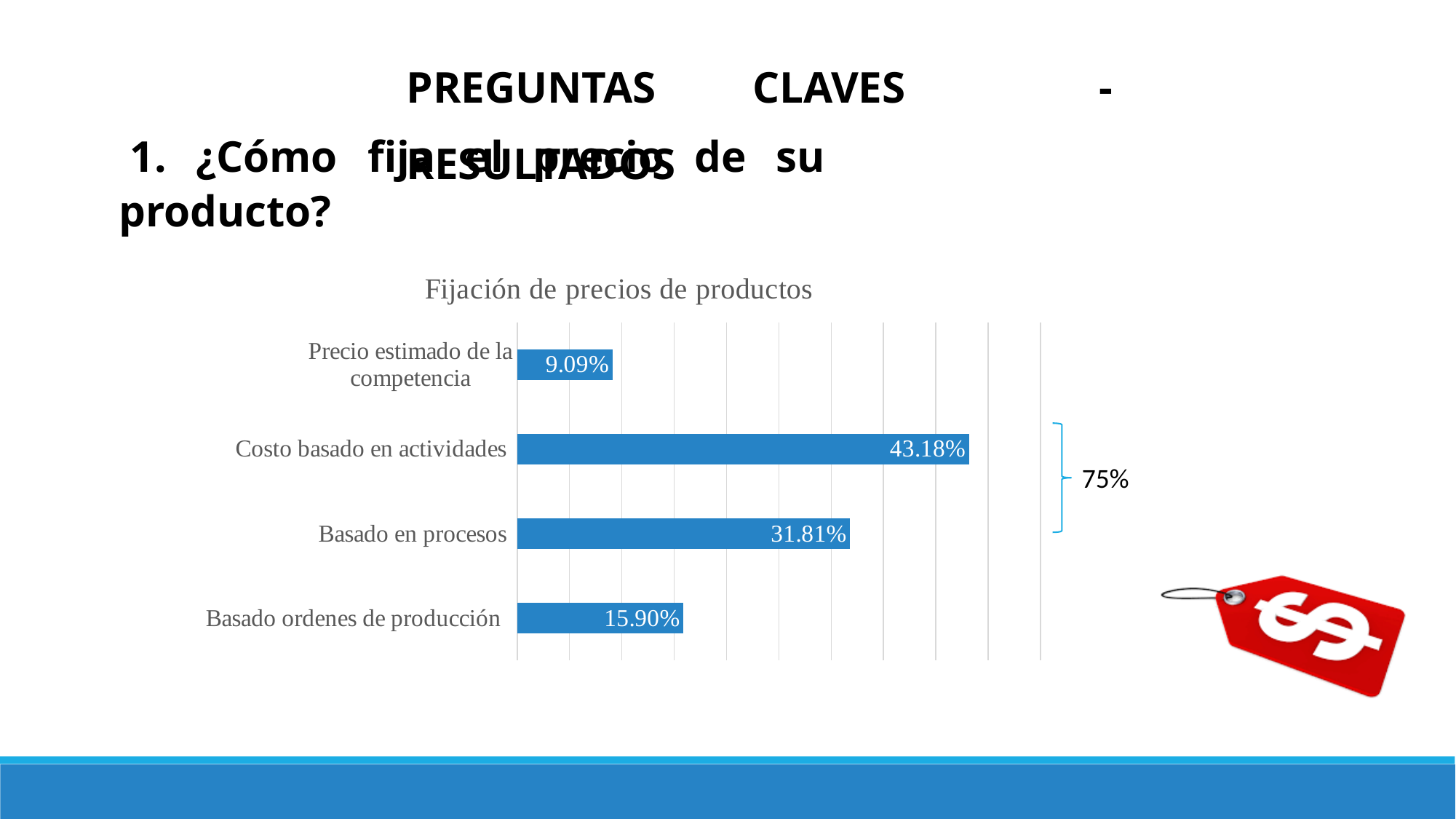
What is the difference between Basado ordenes de producción and Precio estimado de la competencia? 6.81% What is the value for Basado ordenes de producción? 15.90% What is the value for Basado en procesos? 31.81% Which category has the lowest value? Precio estimado de la competencia What is the title of the chart? Fijación de precios de productos Which category has the highest value? Costo basado en actividades What is the value for Precio estimado de la competencia? 9.09% Which is larger, Basado en procesos or Basado ordenes de producción? Basado en procesos What is the difference between Costo basado en actividades and Basado en procesos? 11.37% What is the value for Costo basado en actividades? 43.18% How many categories are shown in the chart? 4 What kind of chart is shown on the slide? Bar chart